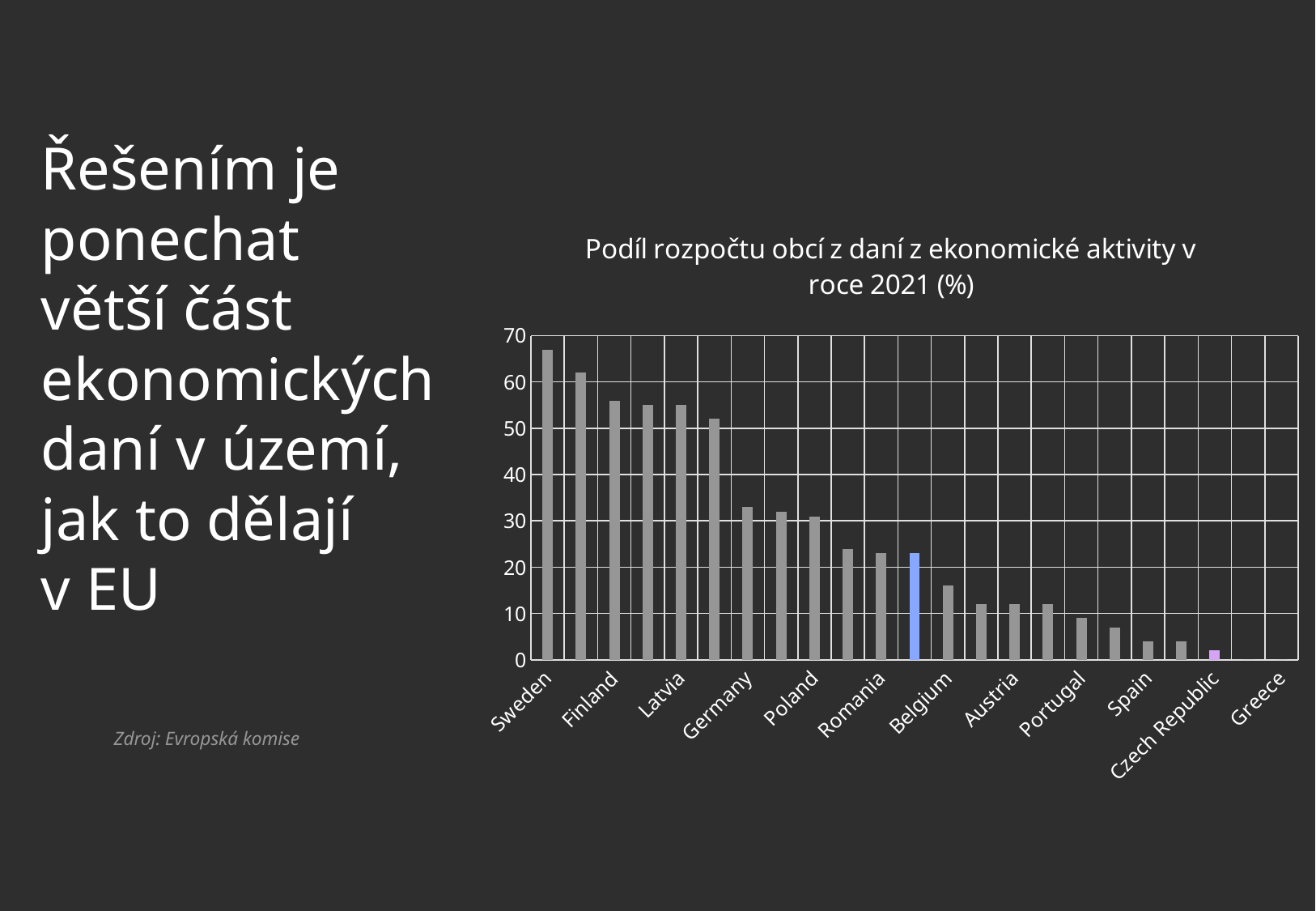
Is the value for Czech Republic greater or less than 10? less Is the value for Sweden greater or less than 60? greater What kind of chart is shown on the slide? bar chart Is the value for Spain greater or less than 10? less Which has a larger value, Germany or Belgium? Germany Which has a larger value, Sweden or Finland? Sweden Which country has the highest value in the chart? Sweden What is the title of the chart? Podíl rozpočtu obcí z daní z ekonomické aktivity v roce 2021 (%) Do the values rise or fall from left to right along the x axis? fall